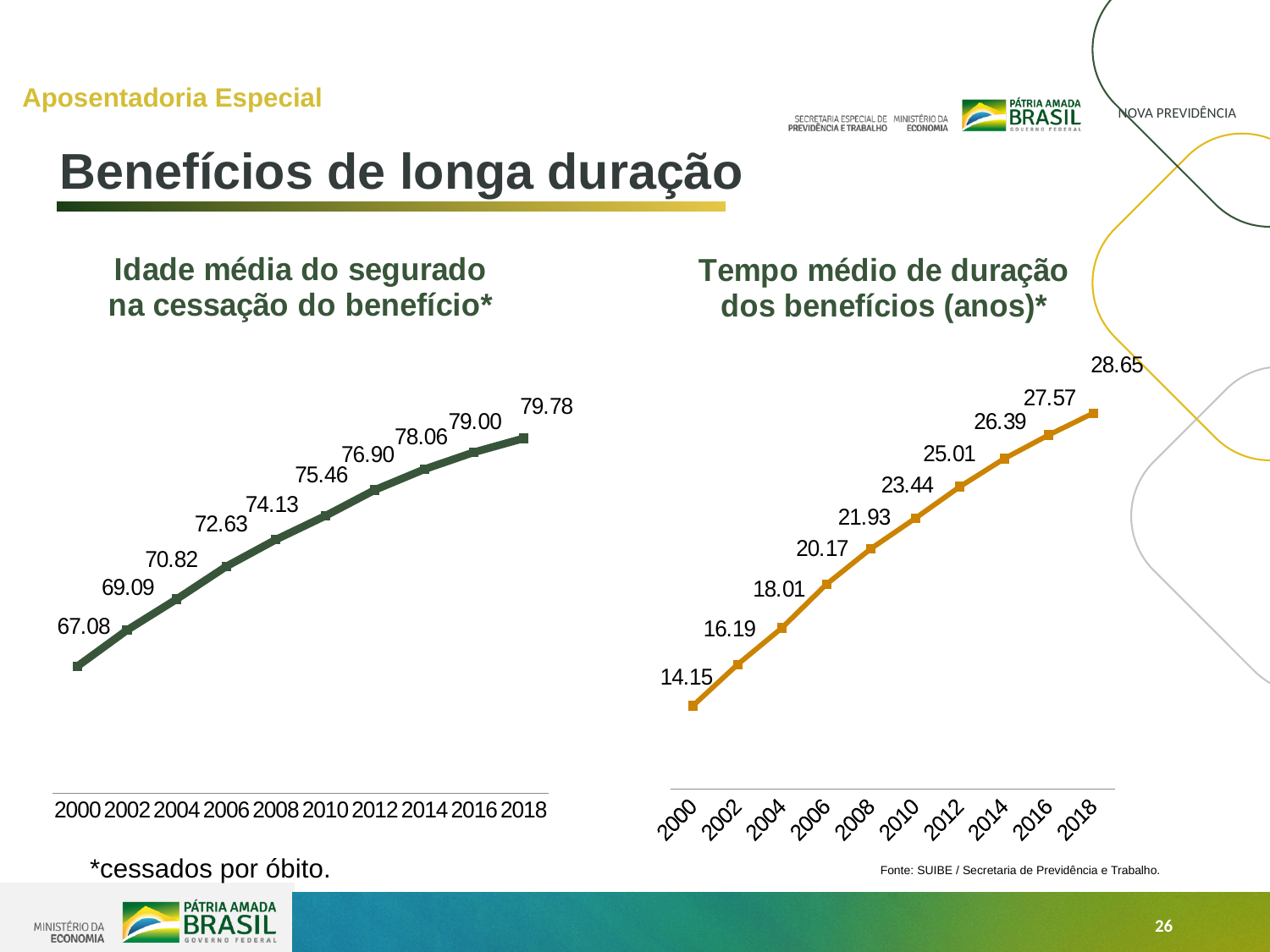
In the chart 'Idade média do segurado na cessação do benefício', what is the difference between the values for 2008 and 2006? 1.50 In the chart 'Idade média do segurado na cessação do benefício', which is larger, the value for 2012 or the value for 2010? 2012 In the chart 'Tempo médio de duração dos benefícios (anos)', what is the value for 2000? 14.15 In the chart 'Tempo médio de duração dos benefícios (anos)', what is the difference between the values for 2018 and 2000? 14.50 In the chart 'Idade média do segurado na cessação do benefício', what is the value for 2000? 67.08 In the chart 'Tempo médio de duração dos benefícios (anos)', do the values rise or fall from 2000 to 2018? rise What kind of chart is 'Idade média do segurado na cessação do benefício'? line chart How many data points are plotted in the chart 'Tempo médio de duração dos benefícios (anos)'? 10 In the chart 'Tempo médio de duração dos benefícios (anos)', what is the value for 2010? 23.44 In the chart 'Idade média do segurado na cessação do benefício', what is the value for 2018? 79.78 In the chart 'Tempo médio de duração dos benefícios (anos)', which year has the highest value? 2018 In the chart 'Idade média do segurado na cessação do benefício', which year has the lowest value? 2000